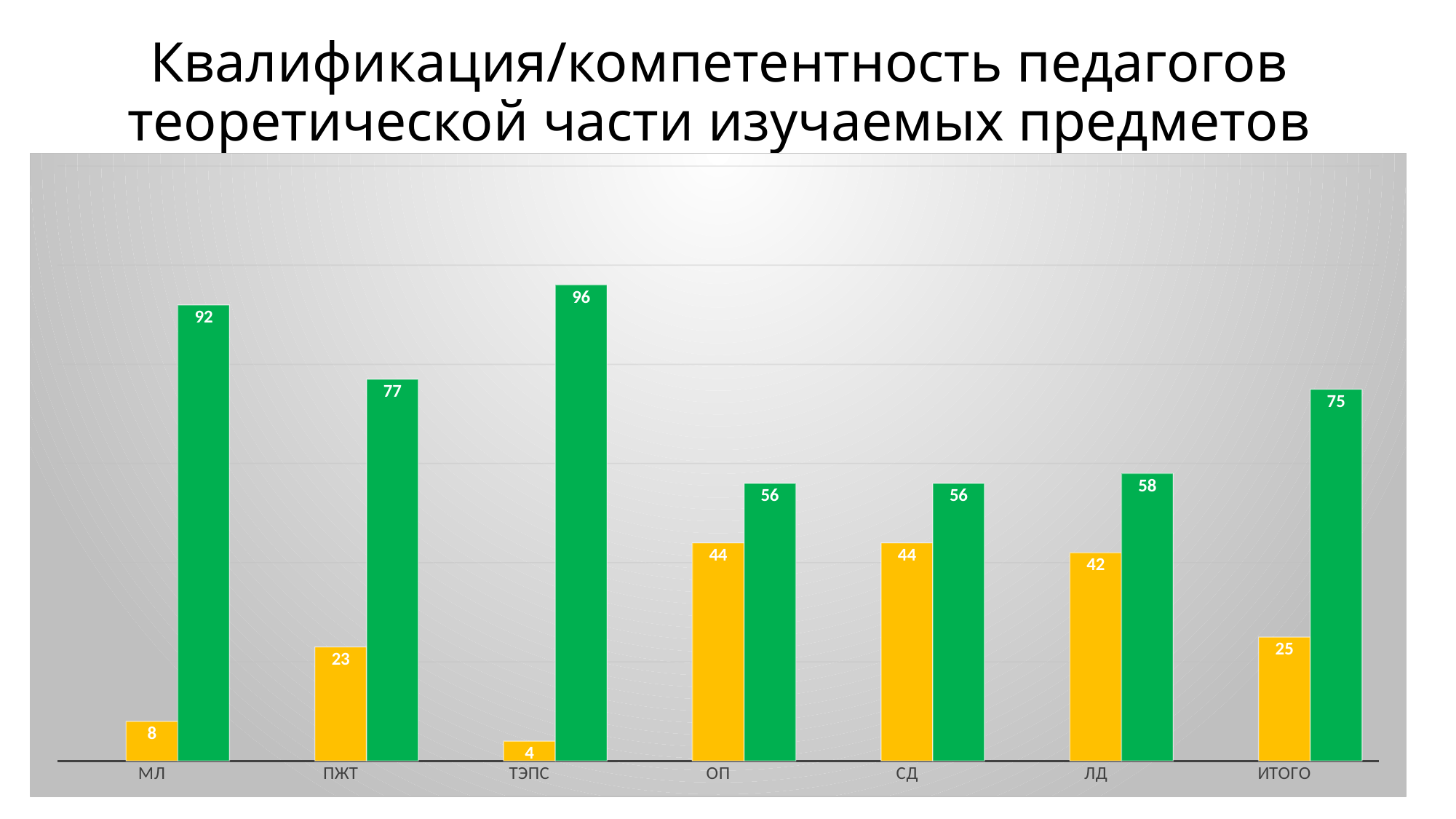
What colours are the two series of bars in the chart? yellow and green What is the difference between the green bar for ТЭПС and the green bar for ПЖТ? 19 What is the value of the yellow bar for ЛД? 42 What type of chart is shown on the slide? bar chart Which is larger: the yellow bar for ОП or the yellow bar for ИТОГО? ОП What is the value of the green bar for ИТОГО? 75 What is the value of the green bar for ТЭПС? 96 Which category has the lowest yellow bar? ТЭПС What is the difference between the green and yellow bars for МЛ? 84 Which category has the highest green bar? ТЭПС What is the value of the yellow bar for ПЖТ? 23 How many categories are shown on the x axis of the chart? 7